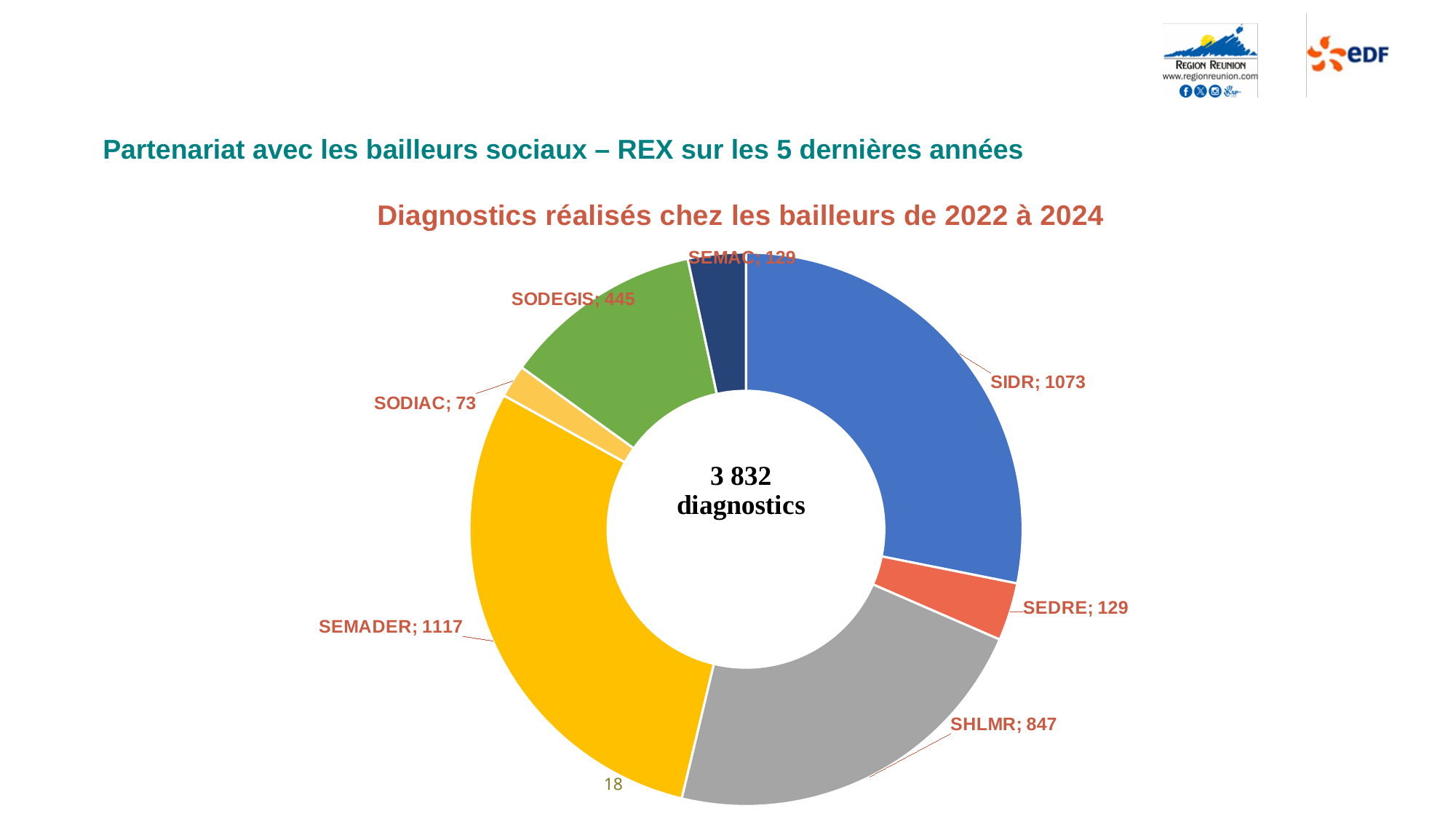
What type of chart is shown on the slide? doughnut chart What is the value for SODIAC? 73 What is the value for SHLMR? 847 What total number of diagnostics is written in the centre of the chart? 3 832 diagnostics What is the value for SODEGIS? 445 What is the difference between the values for SEMADER and SIDR? 44 What is the value for SIDR? 1073 Which is larger, the value for SHLMR or the value for SODEGIS? SHLMR Which bailleur has the lowest number of diagnostics? SODIAC Which bailleur has the highest number of diagnostics? SEMADER How many bailleurs (categories) are shown in the chart? 7 What is the title of the chart? Diagnostics réalisés chez les bailleurs de 2022 à 2024